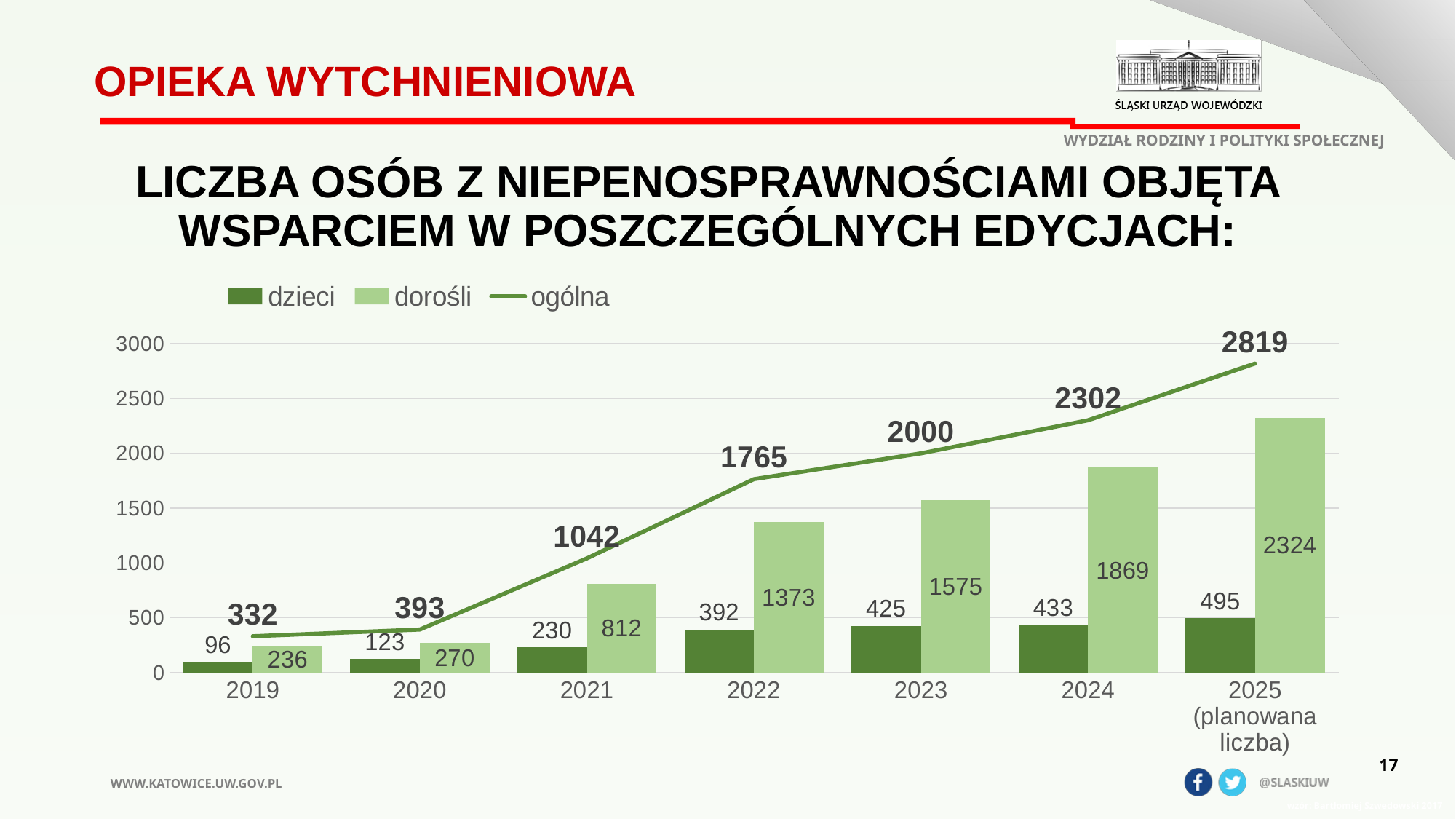
How many series does the legend list? 3 Which year has the highest value for dorośli? 2025 (planowana liczba) Which series is shown as a line rather than bars? ogólna What is the value for dzieci in 2020? 123 What is the value for dorośli in 2022? 1373 Does the ogólna line rise or fall from 2019 to 2025? Rises What is the ogólna value for 2023? 2000 Which is larger: the dorośli value in 2021 or the dzieci value in 2025? dorośli in 2021 What kind of chart is this? Combined bar and line chart Which year has the lowest value for dzieci? 2019 How many years are shown on the x axis? 7 What is the difference between the ogólna values for 2025 and 2024? 517